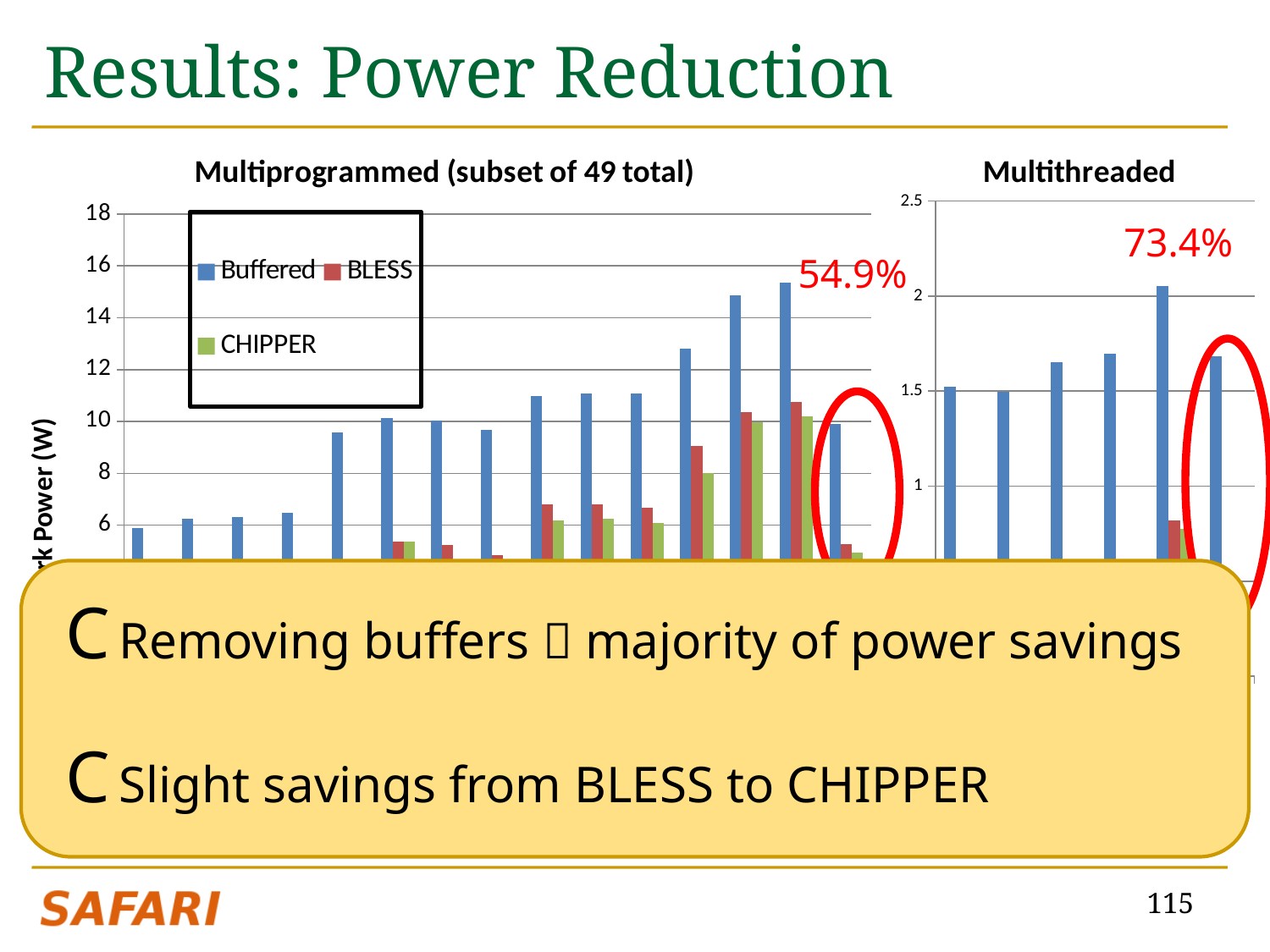
In the Multithreaded chart, is the tallest Buffered bar greater or less than 2? greater In the Multiprogrammed chart, is the tallest Buffered bar greater or less than 14? greater How many Buffered bars are shown in the Multithreaded chart? 6 In the Multiprogrammed chart, is the rightmost (circled) Buffered bar greater or less than 12? less What percentage is annotated in red on the Multithreaded chart? 73.4% In the Multiprogrammed chart, which series has the tallest bars overall, Buffered or CHIPPER? Buffered What percentage is annotated in red on the Multiprogrammed chart? 54.9% How many series does the legend of the Multiprogrammed chart list? 3 What kind of chart is the Multiprogrammed (subset of 49 total) chart? bar chart Which series are listed in the legend of the Multiprogrammed chart? Buffered, BLESS, CHIPPER What is the title of the chart on the right side of the slide? Multithreaded